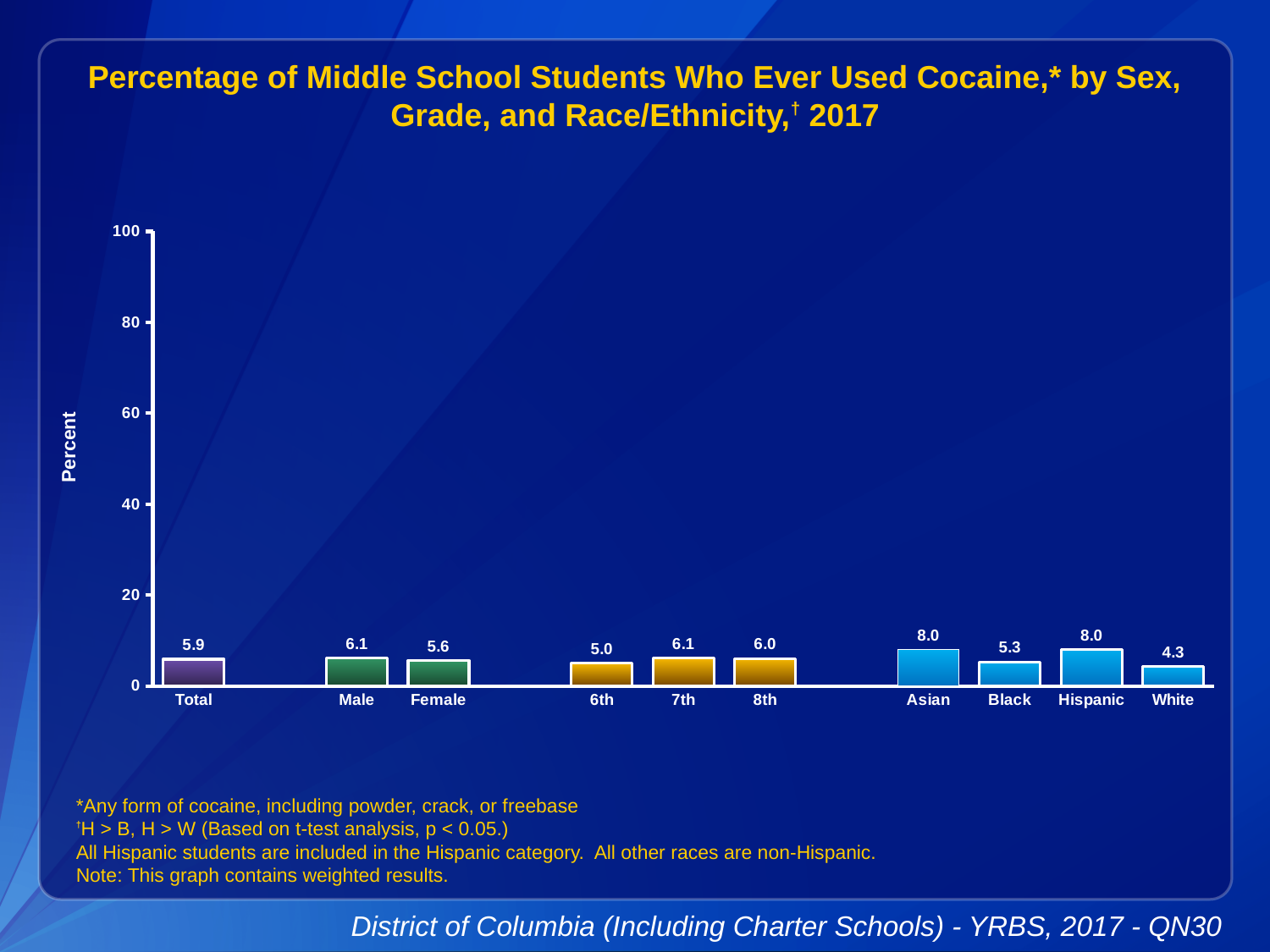
What is the value for White? 4.3 Which category has the lowest value? White What is the value for Total? 5.9 How many categories are shown on the x axis? 10 Which is larger, the value for 7th grade or the value for 8th grade? 7th What is the difference between the values for Hispanic and Black? 2.7 What is the value for Female? 5.6 What is the difference between the values for Male and Female? 0.5 What is the value for 6th grade? 5.0 What kind of chart is shown on the slide? bar chart Is the value for Asian greater or less than 20? less What is the label of the y axis? Percent